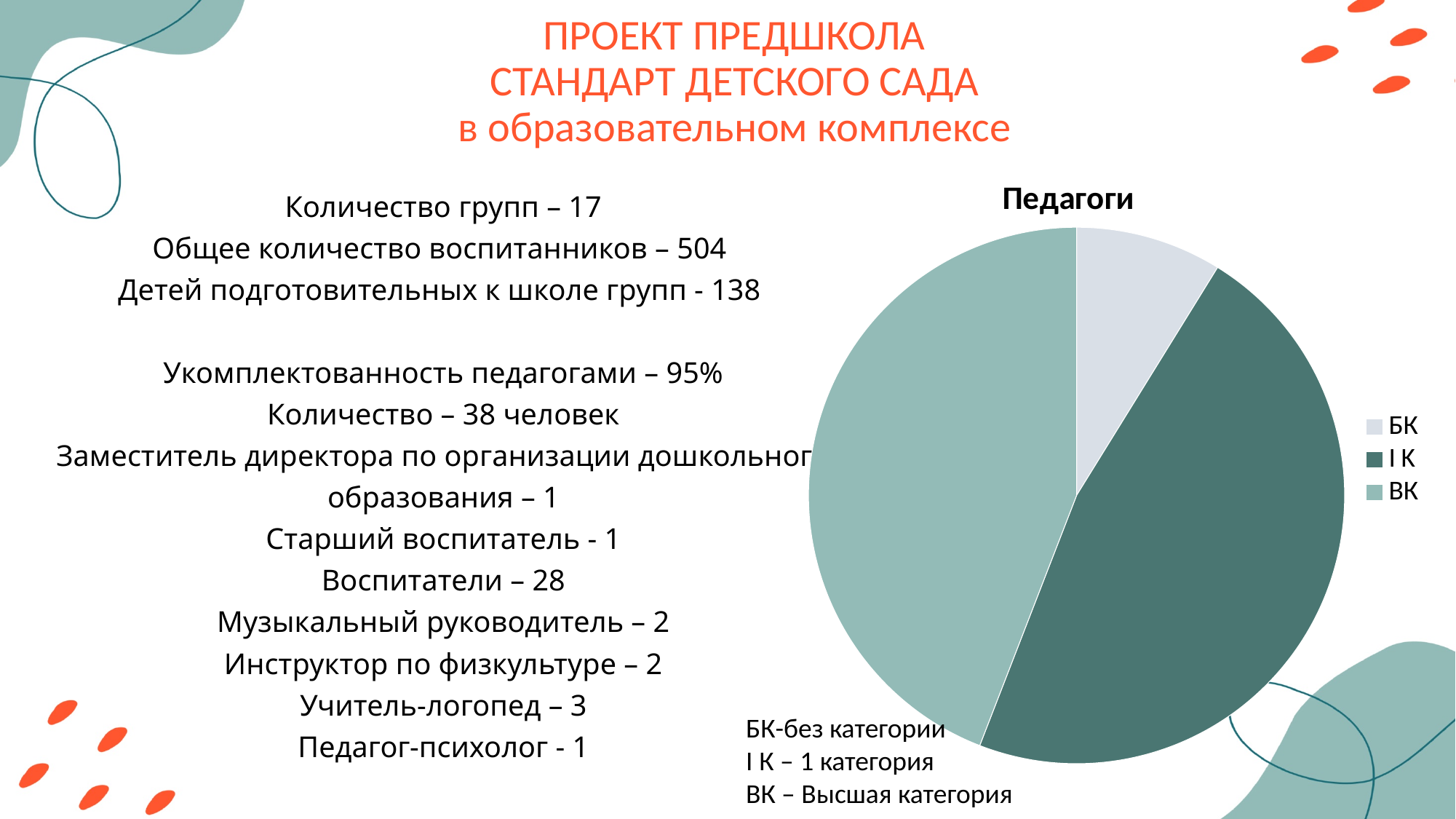
Which slice is larger in the pie chart, БК or ВК? ВК Which legend entry is shown in the lightest colour in the pie chart? БК How many slices does the pie chart have? 3 Which category has the smallest slice in the pie chart? БК Which slice is larger in the pie chart, I К or БК? I К What is the title of the pie chart? Педагоги How many entries does the legend of the pie chart list? 3 What kind of chart is shown on the slide? pie chart